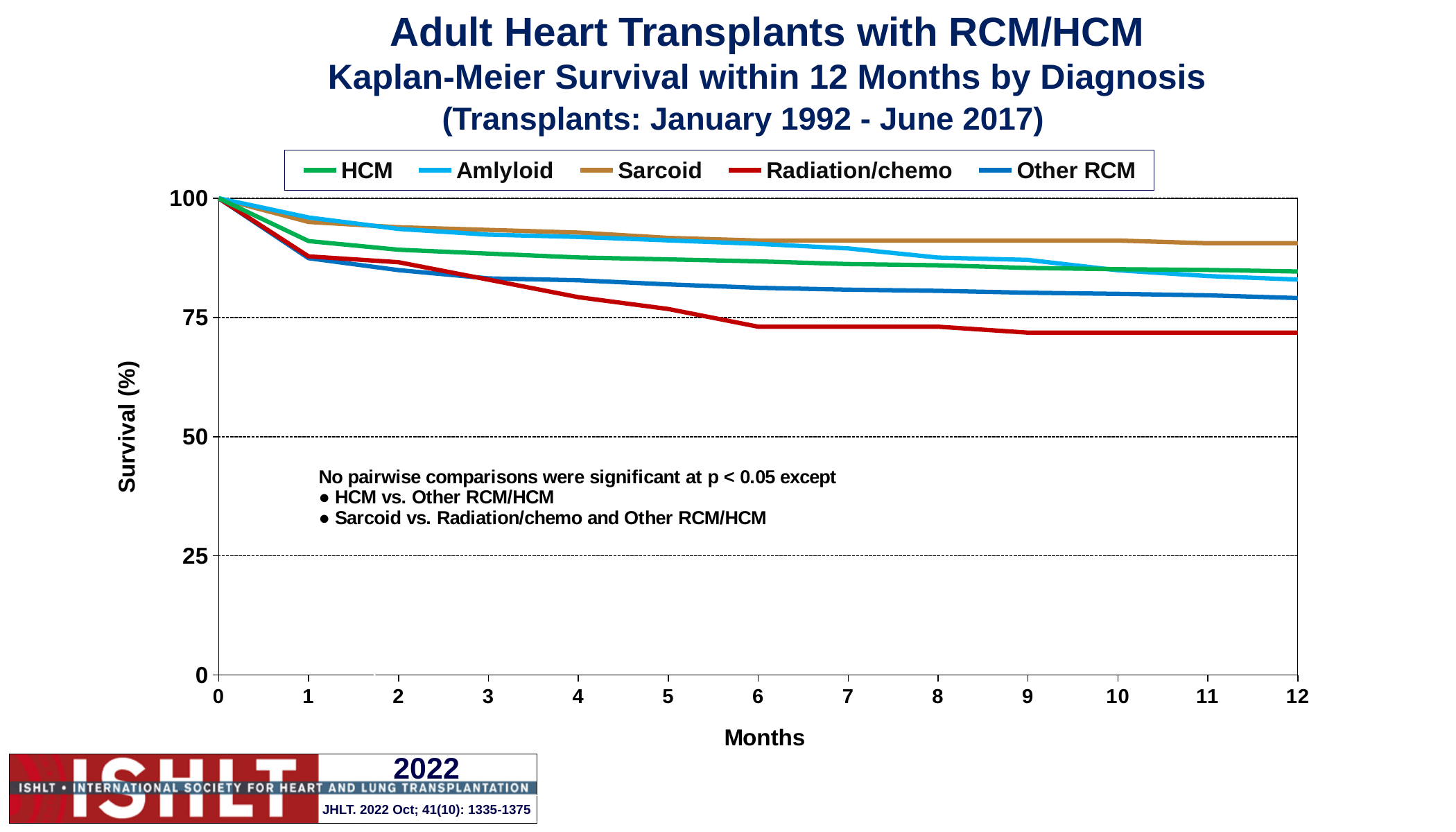
At month 12, which is larger: the survival for HCM or for Other RCM? HCM What is the survival value for HCM at month 0? 100 What kind of chart is shown on the slide? line chart Which series are listed in the legend? HCM, Amlyloid, Sarcoid, Radiation/chemo, Other RCM Is the survival value for Radiation/chemo at month 12 greater or less than 75? less Which series has the highest survival at month 12? Sarcoid How many series does the legend list? 5 At month 6, which is larger: the survival for Radiation/chemo or for Other RCM? Other RCM What is the label of the y axis? Survival (%) Do the survival values rise or fall as months increase? fall Is the survival value for Sarcoid at month 12 greater or less than 75? greater Which series has the lowest survival at month 12? Radiation/chemo